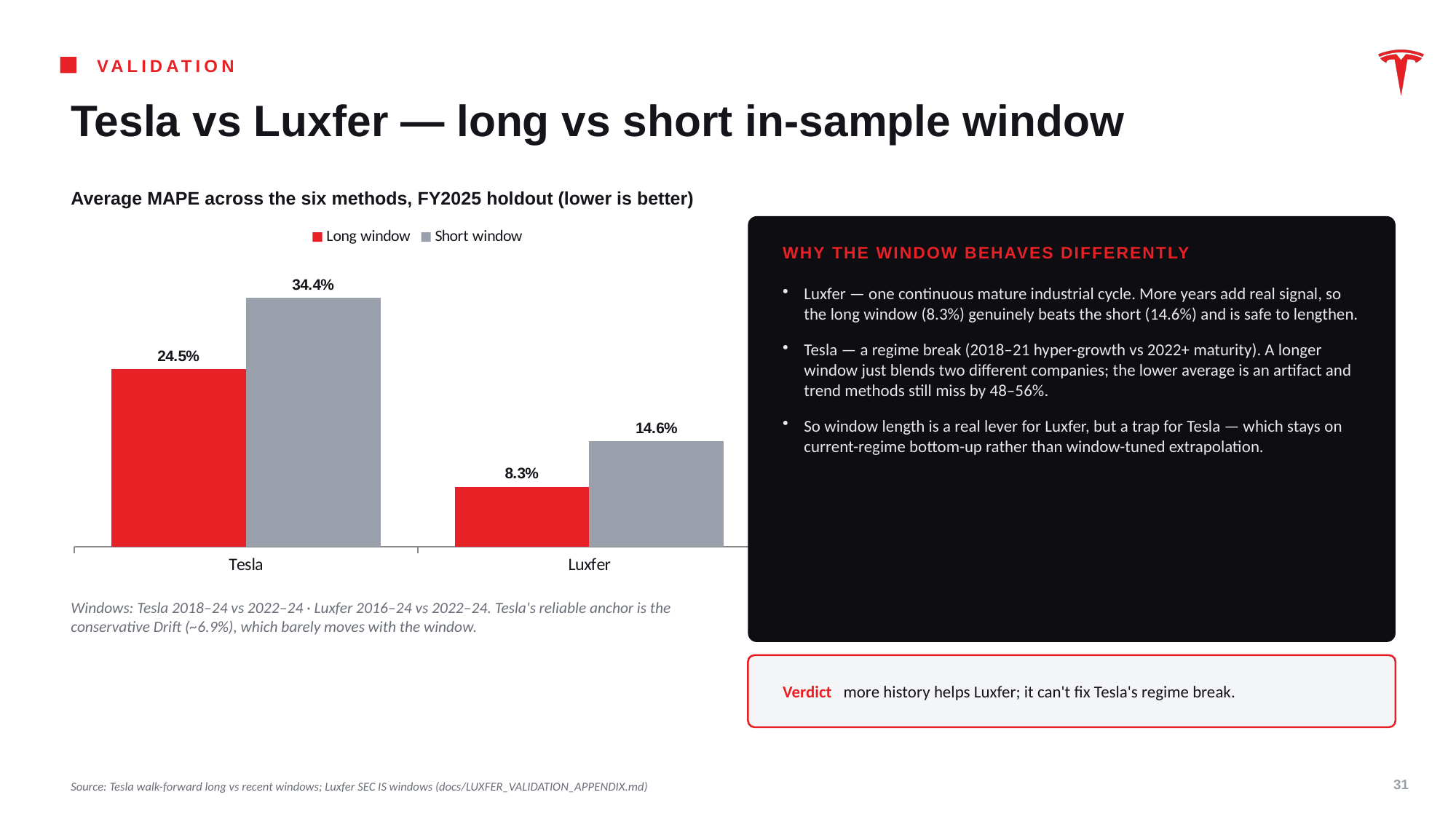
What is the difference between the Short window and Long window values for Luxfer? 6.3% What is the Short window value for Luxfer? 14.6% How many series does the chart legend list? 2 How many companies are shown on the x axis of the chart? 2 What is the Long window value for Tesla? 24.5% What is the difference between the Short window and Long window values for Tesla? 9.9% What is the Short window value for Tesla? 34.4% What is the Long window value for Luxfer? 8.3% Which is larger: the Long window value for Tesla or the Short window value for Luxfer? Long window value for Tesla Which company has the highest Short window value? Tesla Which company has the lowest Long window value? Luxfer What kind of chart is shown on the slide? Bar chart